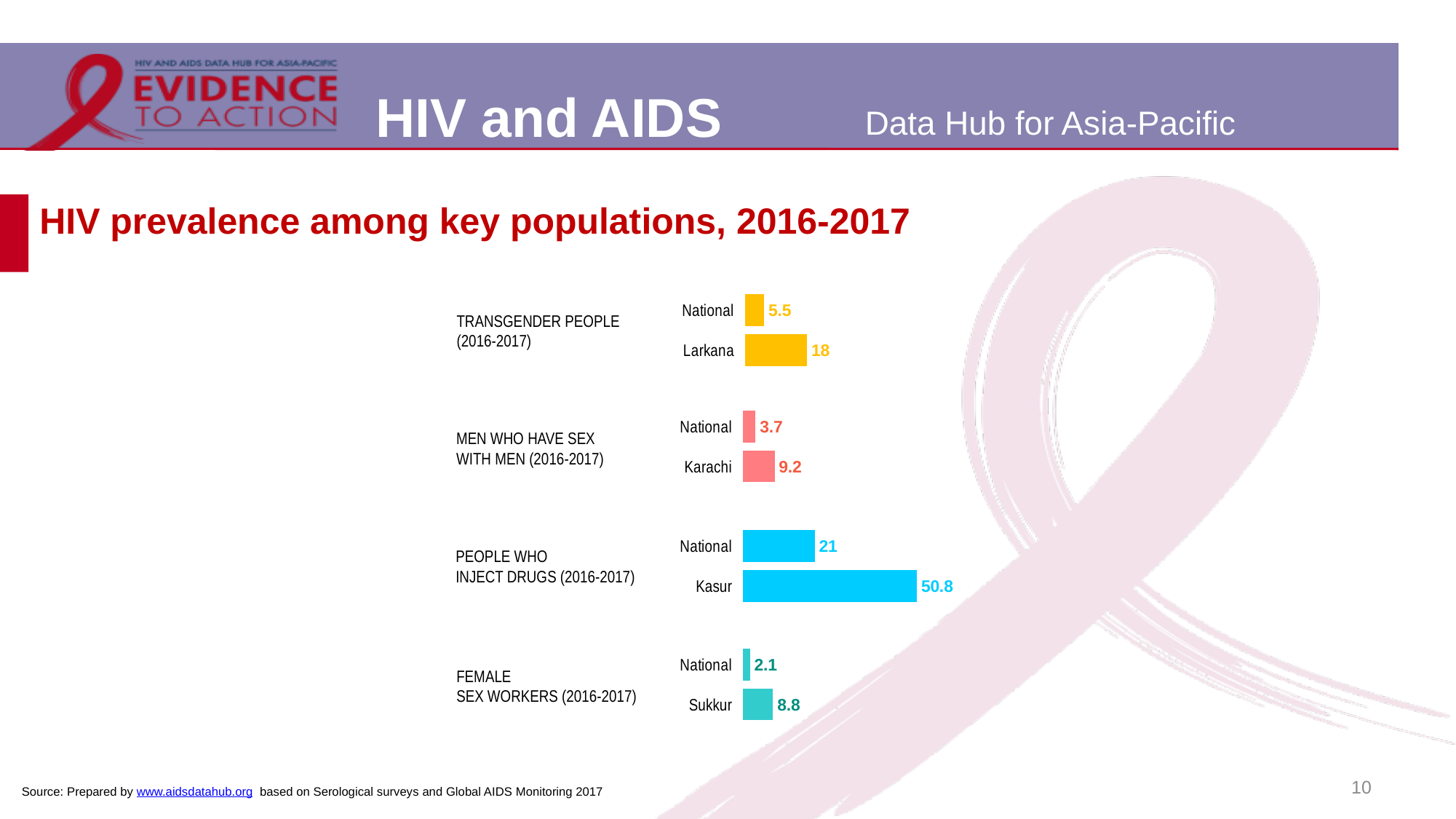
What kind of chart is shown on the slide? Bar chart What is the HIV prevalence value for men who have sex with men in Karachi? 9.2 What is the national HIV prevalence value for transgender people? 5.5 Which bar shows the lowest HIV prevalence value on the chart? National (female sex workers) What is the national HIV prevalence value for female sex workers? 2.1 What is the difference between the Kasur value and the national value for people who inject drugs? 29.8 What is the difference between the Larkana value and the national value for transgender people? 12.5 How many bars are plotted on the chart? 8 What is the HIV prevalence value for people who inject drugs in Kasur? 50.8 Which bar shows the highest HIV prevalence value on the chart? Kasur (people who inject drugs) What is the HIV prevalence value for transgender people in Larkana? 18 Which is larger, the Sukkur value for female sex workers or the Karachi value for men who have sex with men? Karachi